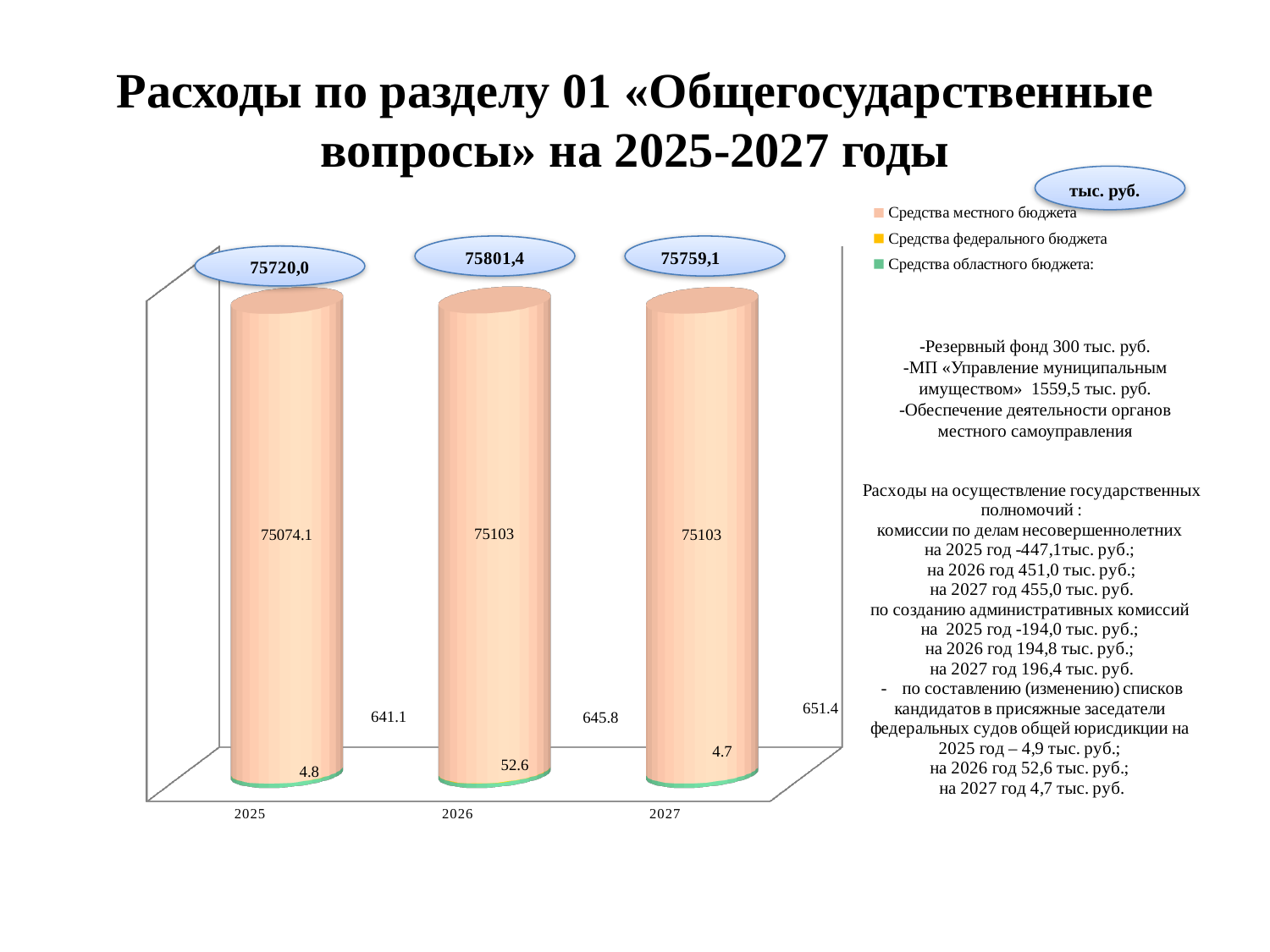
What is the value of Средства местного бюджета for 2025? 75074.1 What is the total shown above the bar for 2025? 75720,0 Which year has the lowest total expenditure shown above its bar? 2025 What is the value of Средства местного бюджета for 2026? 75103 How many series does the chart legend list? 3 Which year has the highest total expenditure shown above its bar? 2026 What is the difference between the Средства местного бюджета values for 2026 and 2025? 28.9 How many years (categories) are shown on the x axis of the chart? 3 What type of chart is shown on the slide? bar chart What is the total shown above the bar for 2026? 75801,4 What is the total shown above the bar for 2027? 75759,1 What unit of measurement is indicated in the oval at the top right of the chart? тыс. руб.